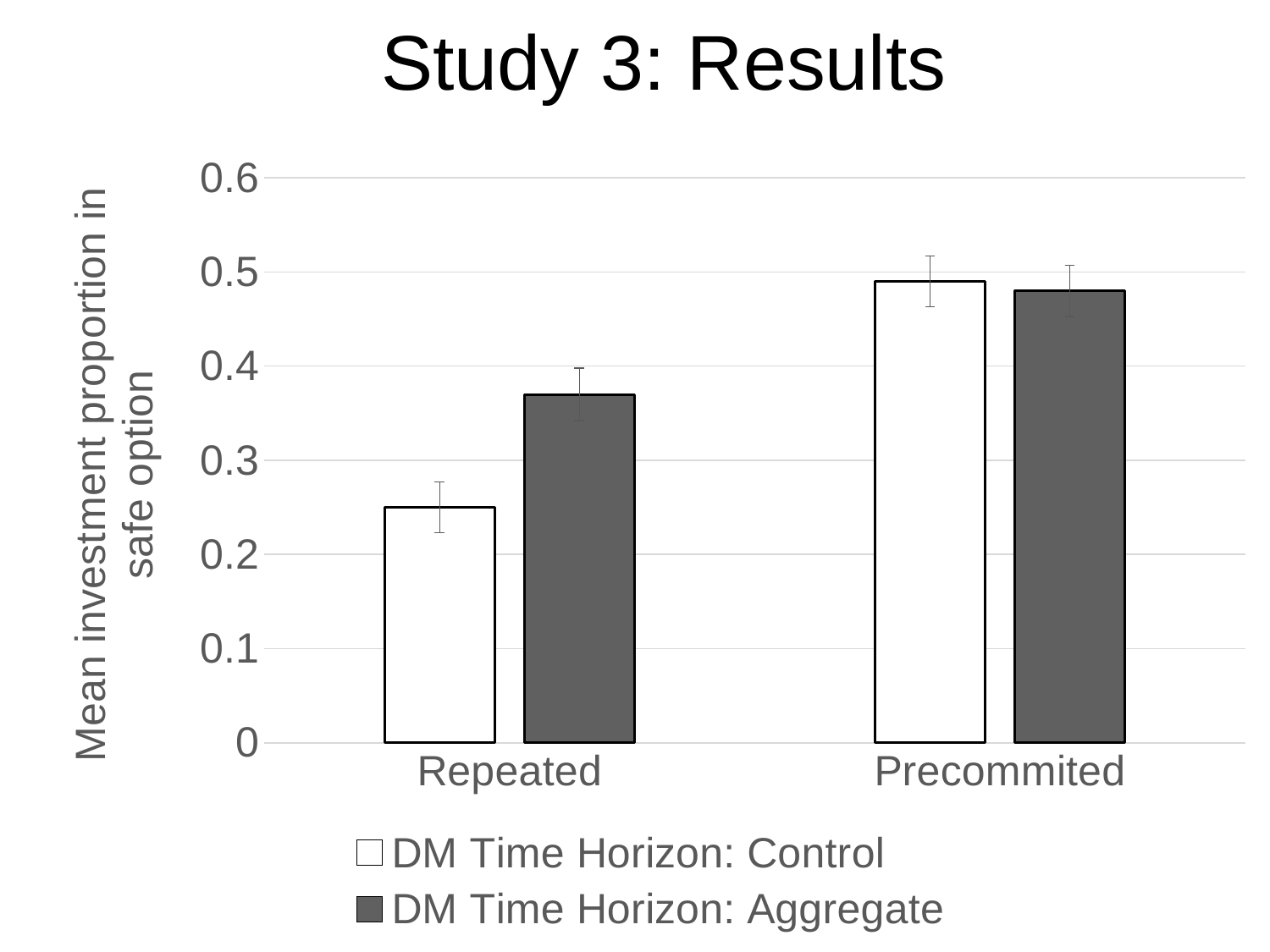
What is the label on the vertical axis? Mean investment proportion in safe option In the Repeated condition, which series has the larger value, DM Time Horizon: Control or DM Time Horizon: Aggregate? DM Time Horizon: Aggregate Which bar has the lowest value in the chart? DM Time Horizon: Control, Repeated What is the title of the chart? Study 3: Results What kind of chart is shown on the slide? bar chart How many series does the legend list? 2 Is the value for DM Time Horizon: Control in the Precommited condition greater or less than 0.4? greater How many categories are shown on the x axis? 2 For the DM Time Horizon: Control series, which condition has the higher value, Repeated or Precommited? Precommited Is the value for DM Time Horizon: Aggregate in the Precommited condition greater or less than 0.4? greater Is the value for DM Time Horizon: Control in the Repeated condition greater or less than 0.3? less